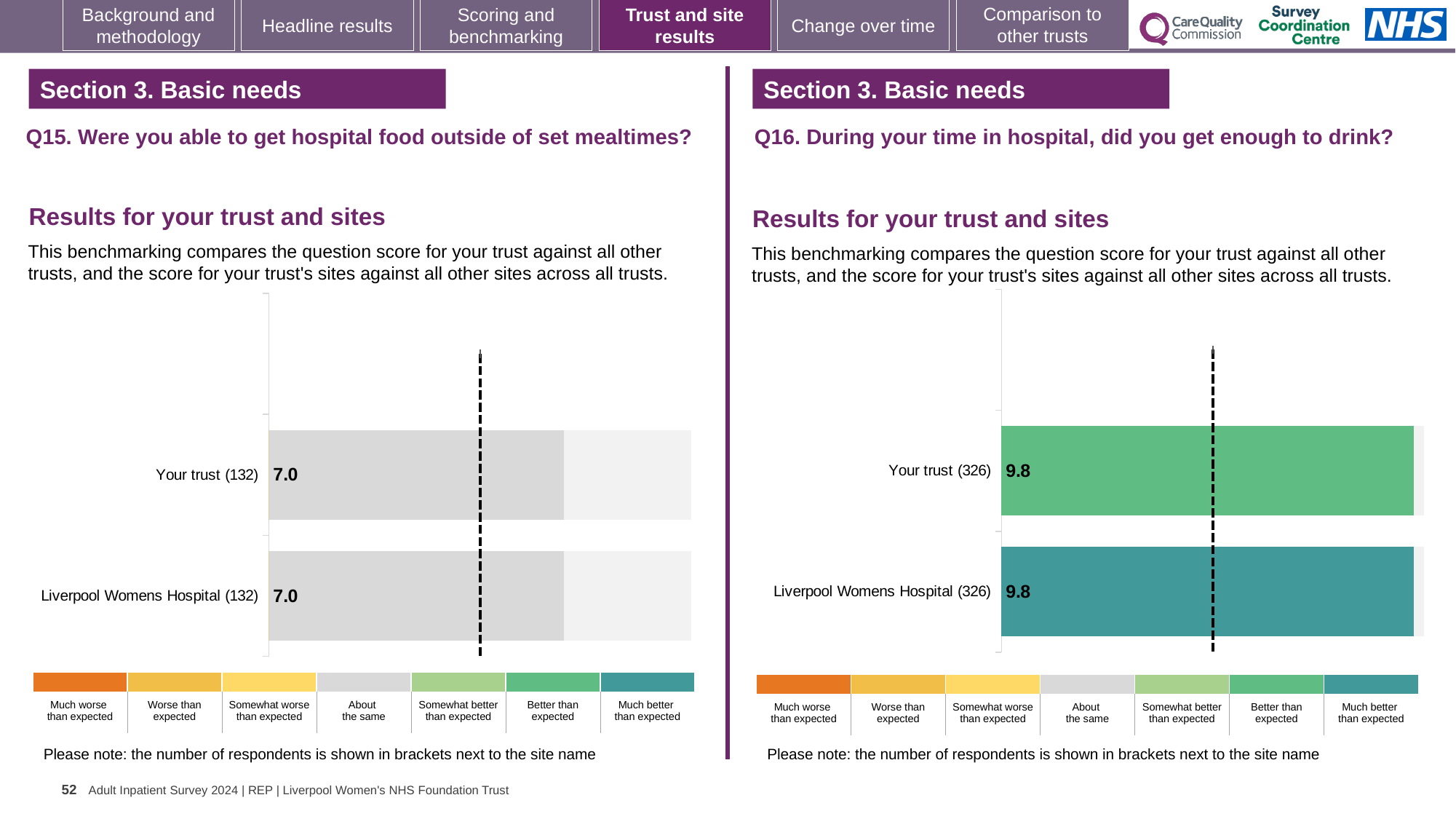
In the Q15 chart on the left, what is the score for Your trust? 7.0 How many bars are plotted in the Q16 chart on the right? 2 In the Q15 chart on the left, how many respondents are shown in brackets for Your trust? 132 What kind of chart is used for the Q16 results on the right? Bar chart In the Q15 chart on the left, what is the difference between the score for Your trust and the score for Liverpool Womens Hospital? 0.0 In the Q16 chart on the right, what is the difference between the score for Your trust and the score for Liverpool Womens Hospital? 0.0 How many bars are plotted in the Q15 chart on the left? 2 In the Q16 chart on the right, what is the score for Liverpool Womens Hospital? 9.8 In the Q15 chart on the left, what is the score for Liverpool Womens Hospital? 7.0 In the Q15 chart on the left, which benchmark category does the colour of the Your trust bar correspond to in the legend? About the same In the Q16 chart on the right, how many respondents are shown in brackets for Liverpool Womens Hospital? 326 In the Q16 chart on the right, what is the score for Your trust? 9.8